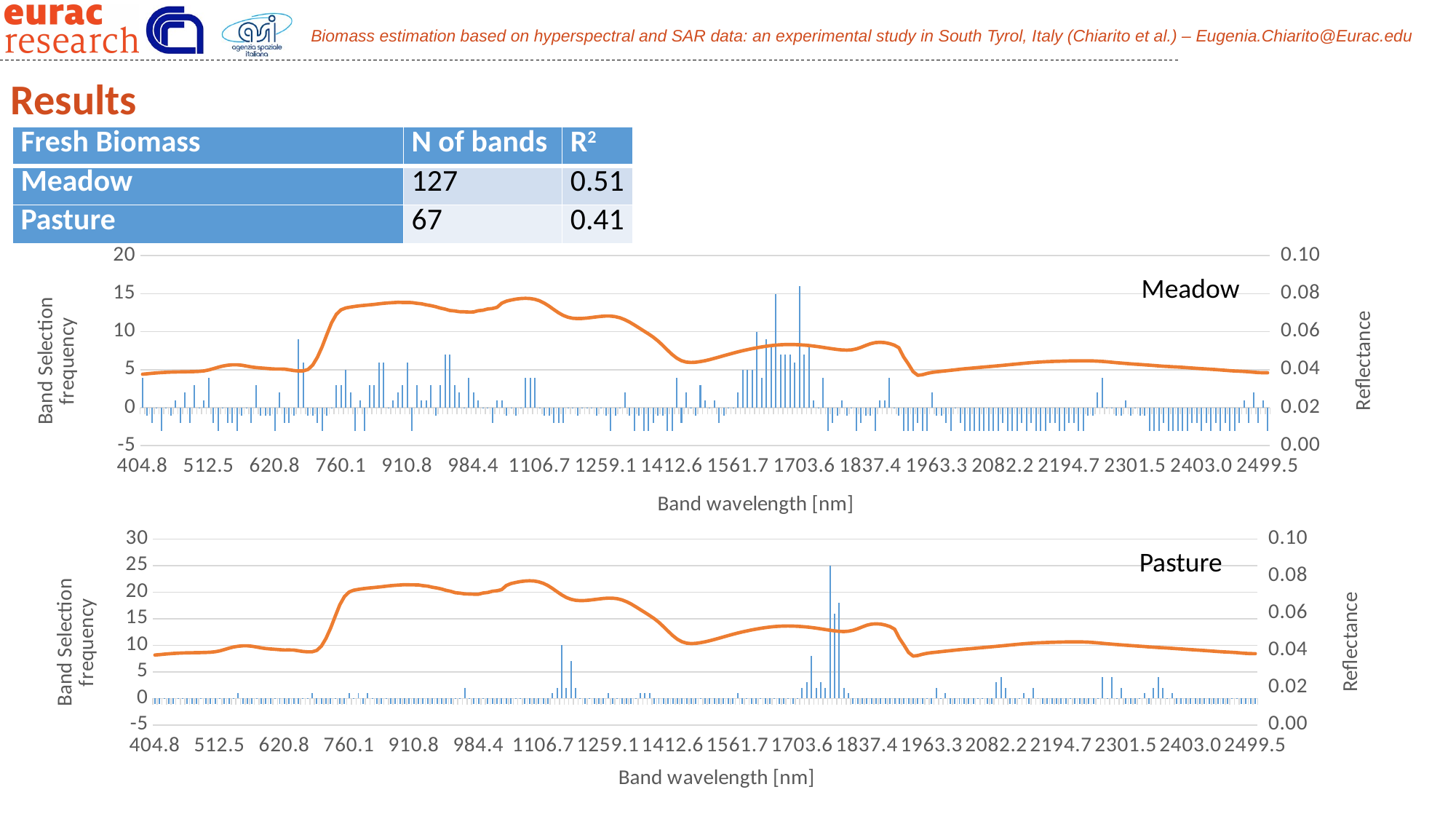
How many charts are shown on the slide? 2 In the Meadow chart, is the highest band selection frequency bar greater or less than 10? greater In the Meadow chart, is the reflectance at 404.8 nm greater or less than 0.06? less How many wavelength labels are shown along the x axis of the Meadow chart? 18 In the Pasture chart, is the highest band selection frequency bar greater or less than 20? greater What is the title of the right-hand vertical axis on the Meadow chart? Reflectance What kind of chart is the Meadow chart? Combined bar and line chart What is the x-axis title of the Pasture chart? Band wavelength [nm] In the Pasture chart, does the reflectance rise or fall between 620.8 nm and 760.1 nm? rise Which chart, Meadow or Pasture, has the higher maximum band selection frequency? Pasture